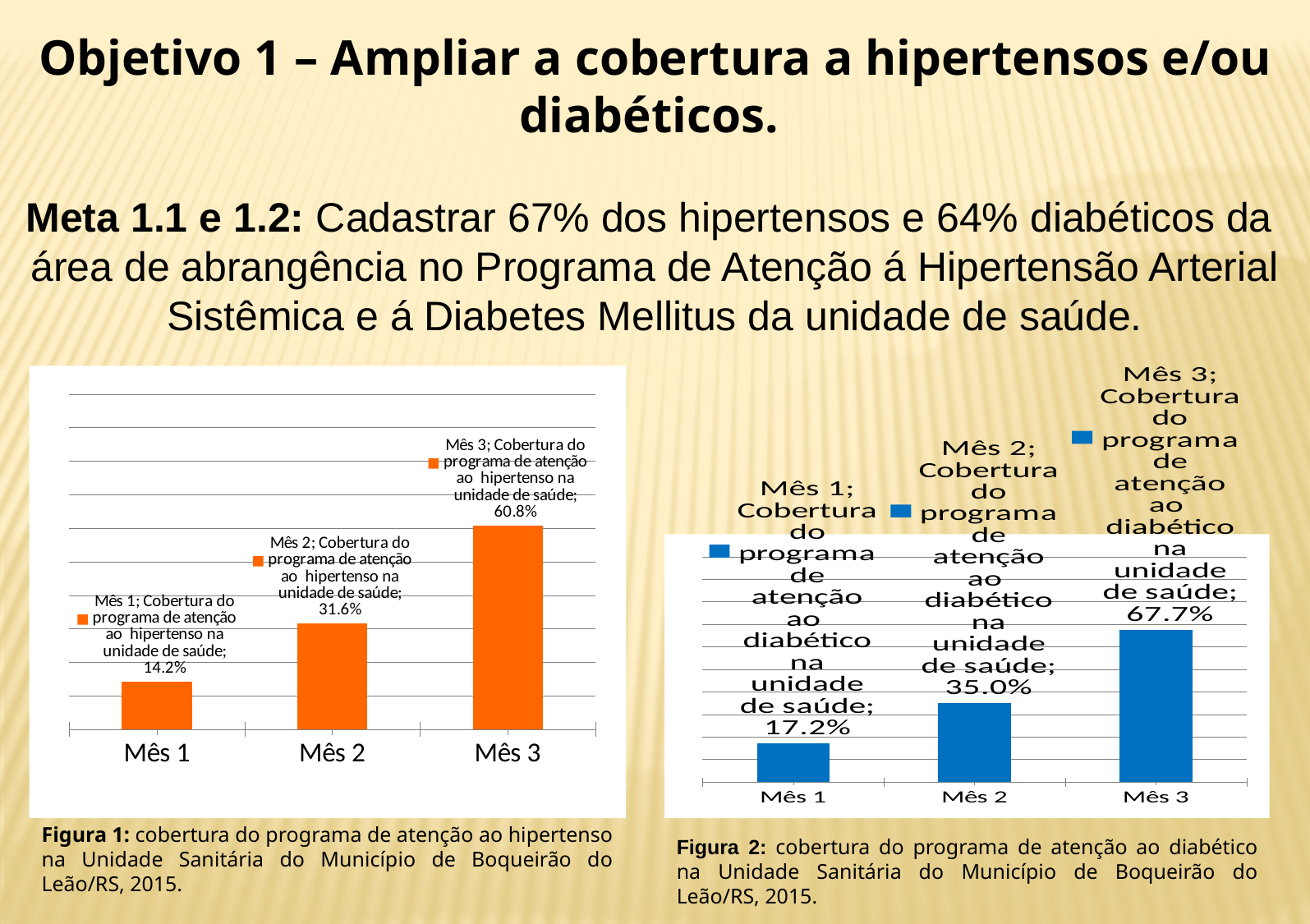
In the left chart (Figura 1, hypertension coverage), what is the value for Mês 1? 14.2% In the left chart (Figura 1, hypertension coverage), which month has the highest value? Mês 3 In the left chart (Figura 1, hypertension coverage), what is the difference between Mês 3 and Mês 2? 29.2% In the left chart (Figura 1, hypertension coverage), do the values rise or fall from Mês 1 to Mês 3? Rise What type of chart is the right chart (Figura 2)? Bar chart In the right chart (Figura 2, diabetes coverage), what is the difference between Mês 2 and Mês 1? 17.8% In the right chart (Figura 2, diabetes coverage), what is the value for Mês 3? 67.7% In the right chart (Figura 2, diabetes coverage), which month has the lowest value? Mês 1 How many months (categories) are shown in the left chart (Figura 1)? 3 Which is larger: the Mês 2 value in the left chart (Figura 1) or the Mês 2 value in the right chart (Figura 2)? Figura 2 (35.0%) In the right chart (Figura 2, diabetes coverage), what is the value for Mês 2? 35.0% In the left chart (Figura 1, hypertension coverage), what is the value for Mês 3? 60.8%